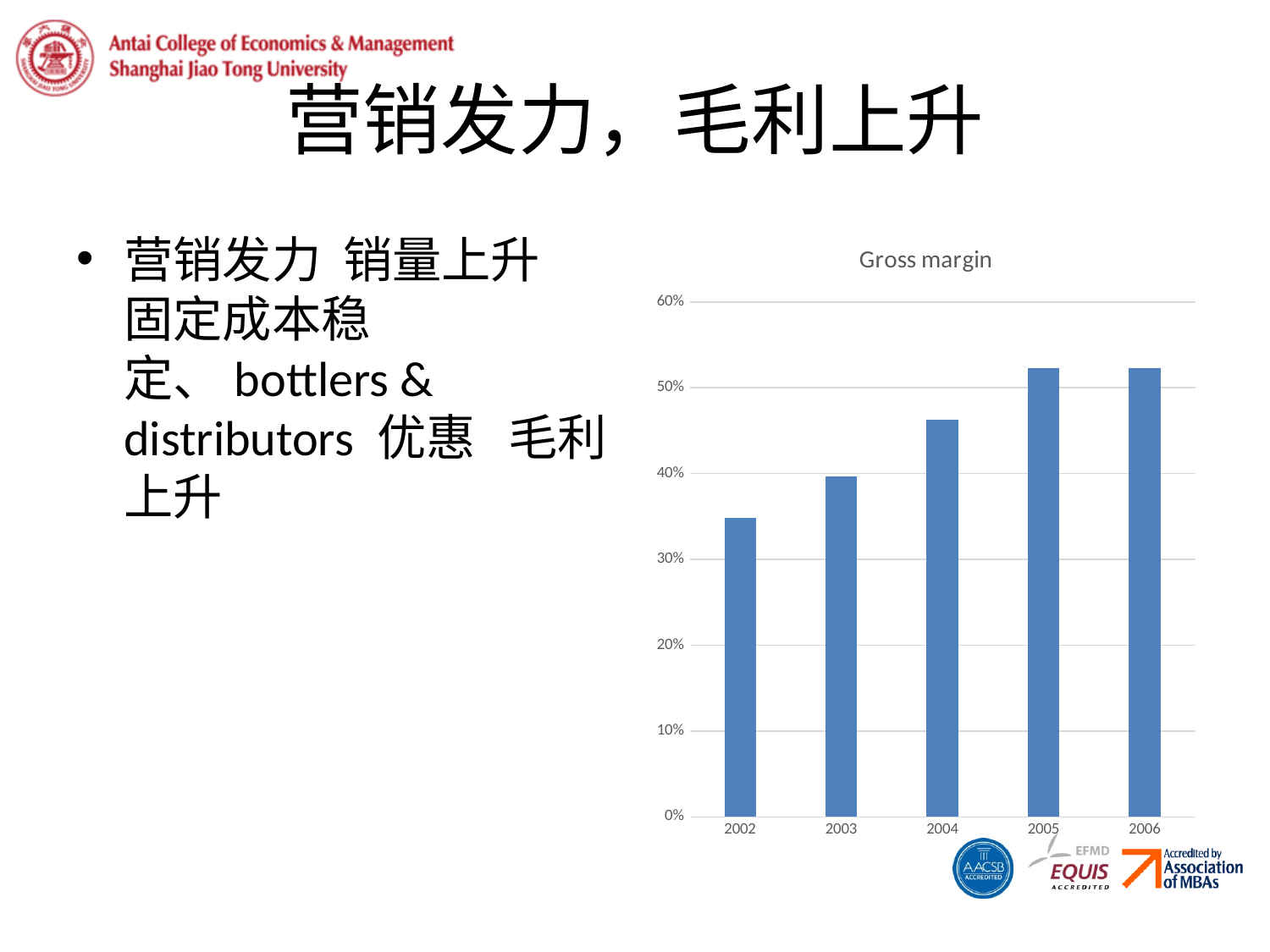
What is the highest value shown on the vertical axis of the chart? 60% What is the title of the chart? Gross margin Which year has the larger gross margin, 2002 or 2004? 2004 Do the gross margin values rise or fall from 2002 to 2006? rise Is the gross margin for 2004 greater or less than 50%? less What kind of chart is shown on the slide? bar chart Is the gross margin for 2005 greater or less than 50%? greater Which year has the lowest gross margin? 2002 Is the gross margin for 2002 greater or less than 30%? greater How many years are plotted in the Gross margin chart? 5